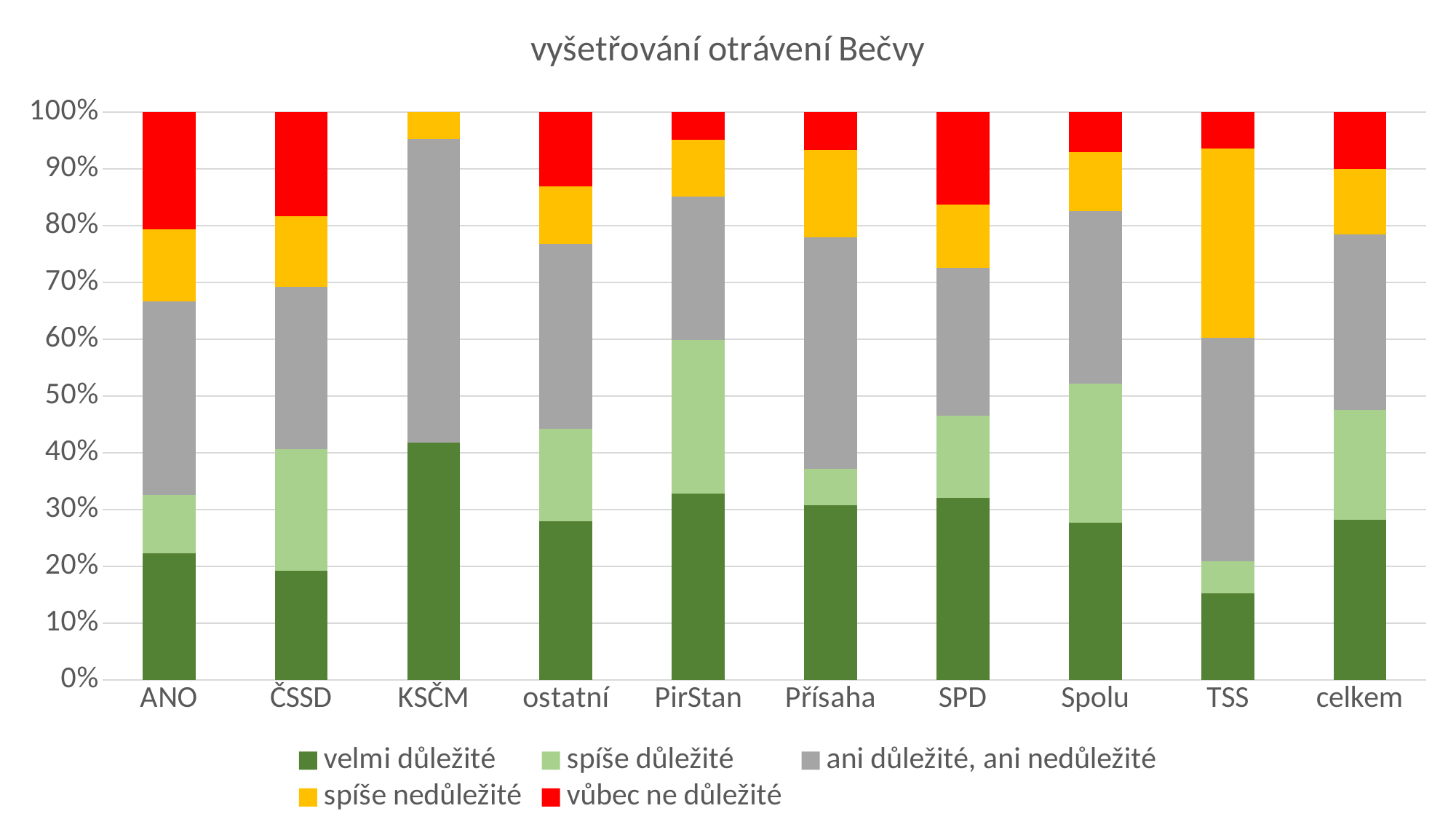
Is the 'velmi důležité' share for TSS greater or less than 20%? less Which category has the largest 'spíše nedůležité' segment? TSS Which category has the smallest 'velmi důležité' segment? TSS What type of chart is shown on the slide? stacked bar chart Which has a larger 'vůbec ne důležité' segment, ANO or PirStan? ANO Which colour represents 'vůbec ne důležité' in the legend? red Is the 'velmi důležité' share for KSČM greater or less than 30%? greater How many categories are shown on the x axis? 10 Which category has the largest 'velmi důležité' segment? KSČM What is the title of the chart? vyšetřování otrávení Bečvy Which category has no 'vůbec ne důležité' segment at all? KSČM How many series does the legend list? 5